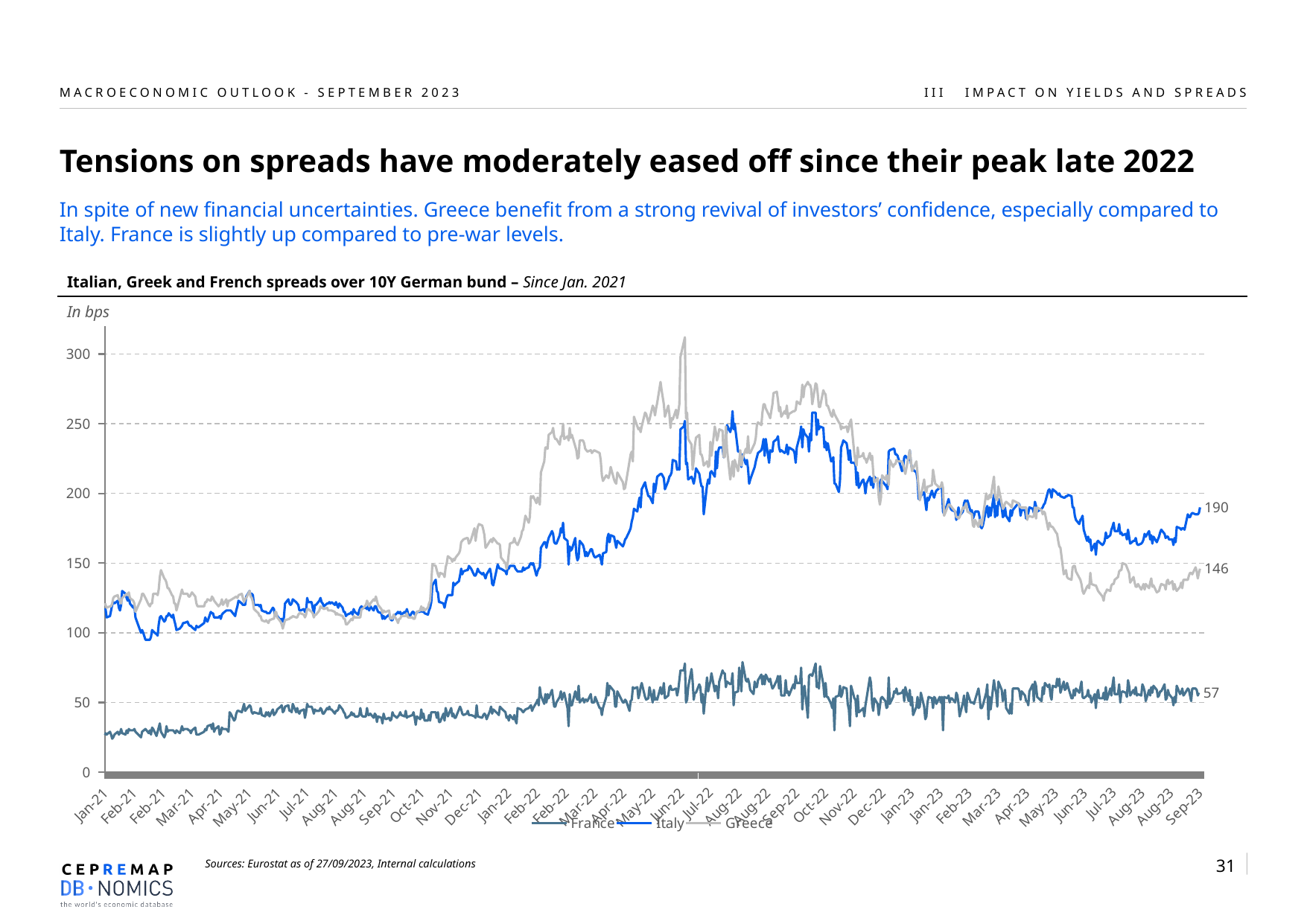
At the right end of the chart, is the value for Greece larger or smaller than the value for Italy? smaller Which series has the lowest value at the right end of the chart? France What is the difference between the end values labelled for Italy and Greece? 44 What kind of chart is shown on the slide? line chart What is the latest value shown for Italy at the right end of the chart? 190 What is the latest value shown for Greece at the right end of the chart? 146 What is the difference between the end values labelled for Italy and France? 133 What is the latest value shown for France at the right end of the chart? 57 How many series does the legend list? 3 Is the peak value for Greece around Jun-22 greater or less than 300? greater Which series has the highest value at the right end of the chart? Italy Is the value for France in Jan-21 greater or less than 50? less